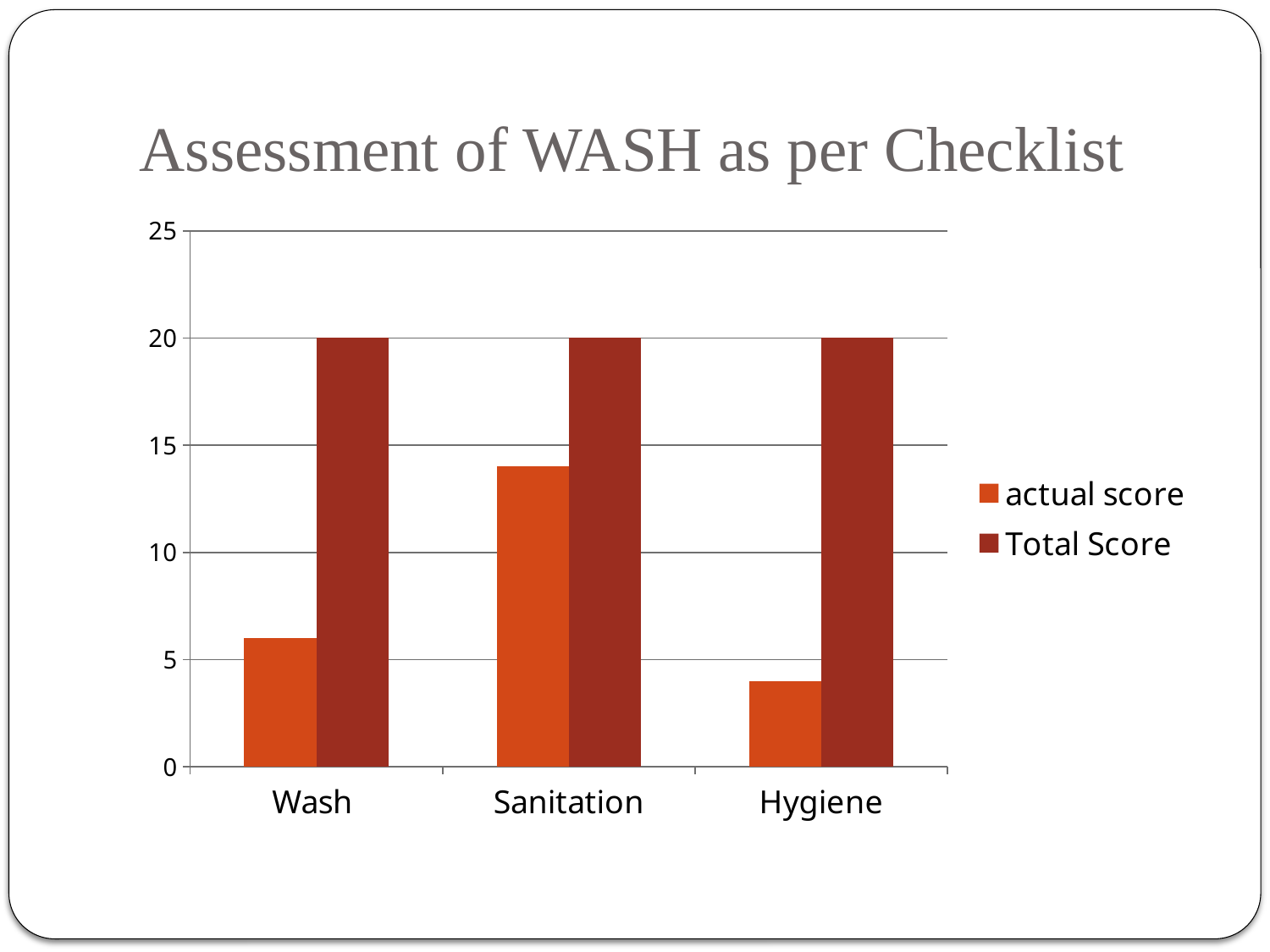
What is the Total Score for Hygiene? 20 Is the actual score for Hygiene greater or less than 5? less Which category has the highest actual score? Sanitation How many categories are shown on the x axis? 3 What is the Total Score for Wash? 20 Which is larger, the actual score for Wash or the actual score for Hygiene? Wash What is the title of the chart? Assessment of WASH as per Checklist What kind of chart is shown on the slide? bar chart How many series does the legend list? 2 Which series is shown in the darker red bars? Total Score Is the actual score for Sanitation greater or less than 10? greater Which category has the lowest actual score? Hygiene